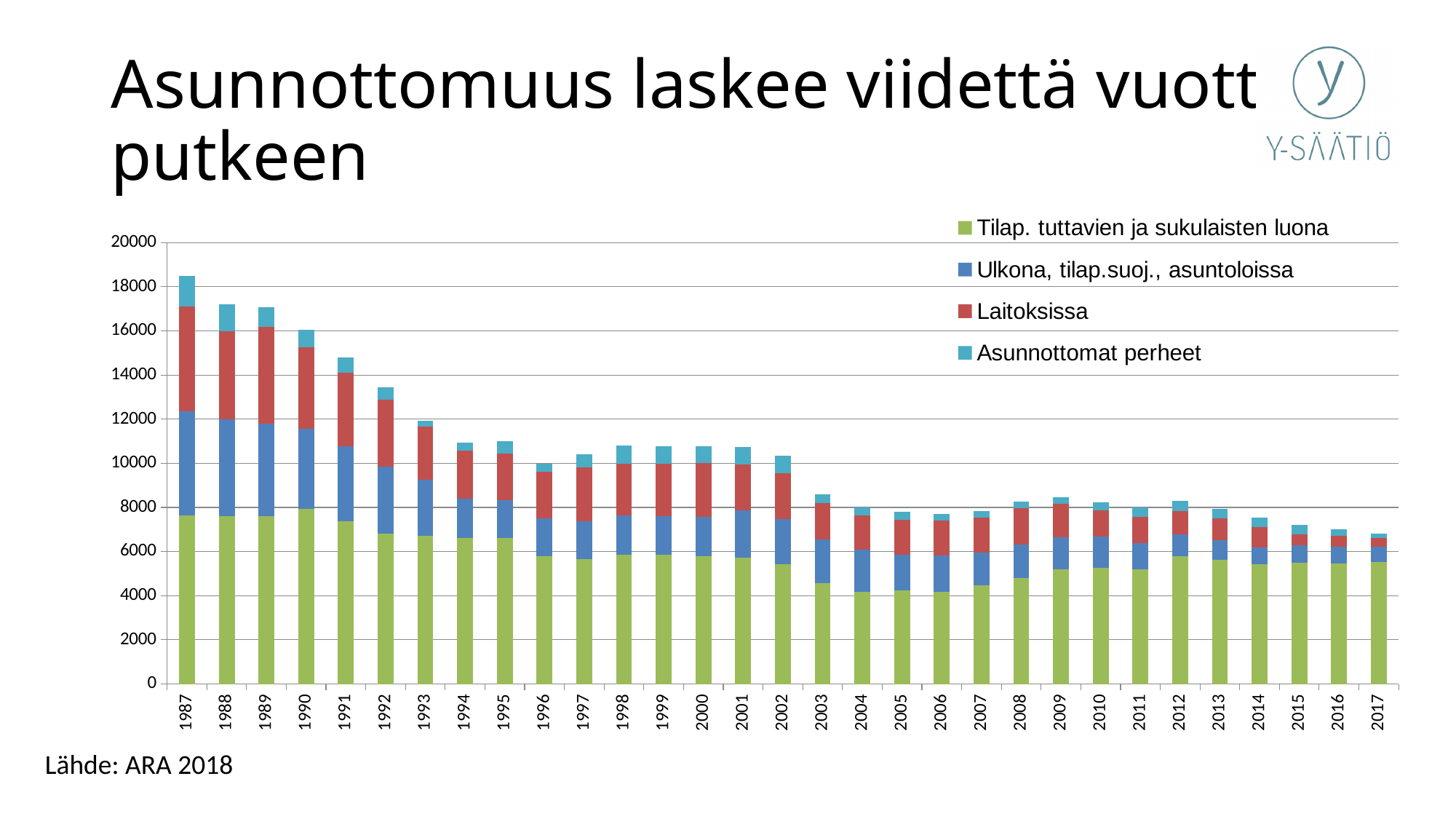
Is the total for 2003 greater or less than 8000? greater How many years are shown on the x axis? 31 Is the total for 2017 greater or less than 8000? less Which year has the larger total bar, 1987 or 1988? 1987 Do the total bar heights generally rise or fall from 1987 to 2017? Fall What kind of chart is shown on the slide? Stacked bar chart Which year has the highest total bar? 1987 How many series does the legend list? 4 What is the first series listed in the legend? Tilap. tuttavien ja sukulaisten luona Which year has the larger total bar, 2006 or 2009? 2009 Is the total for 2000 greater or less than 10000? greater